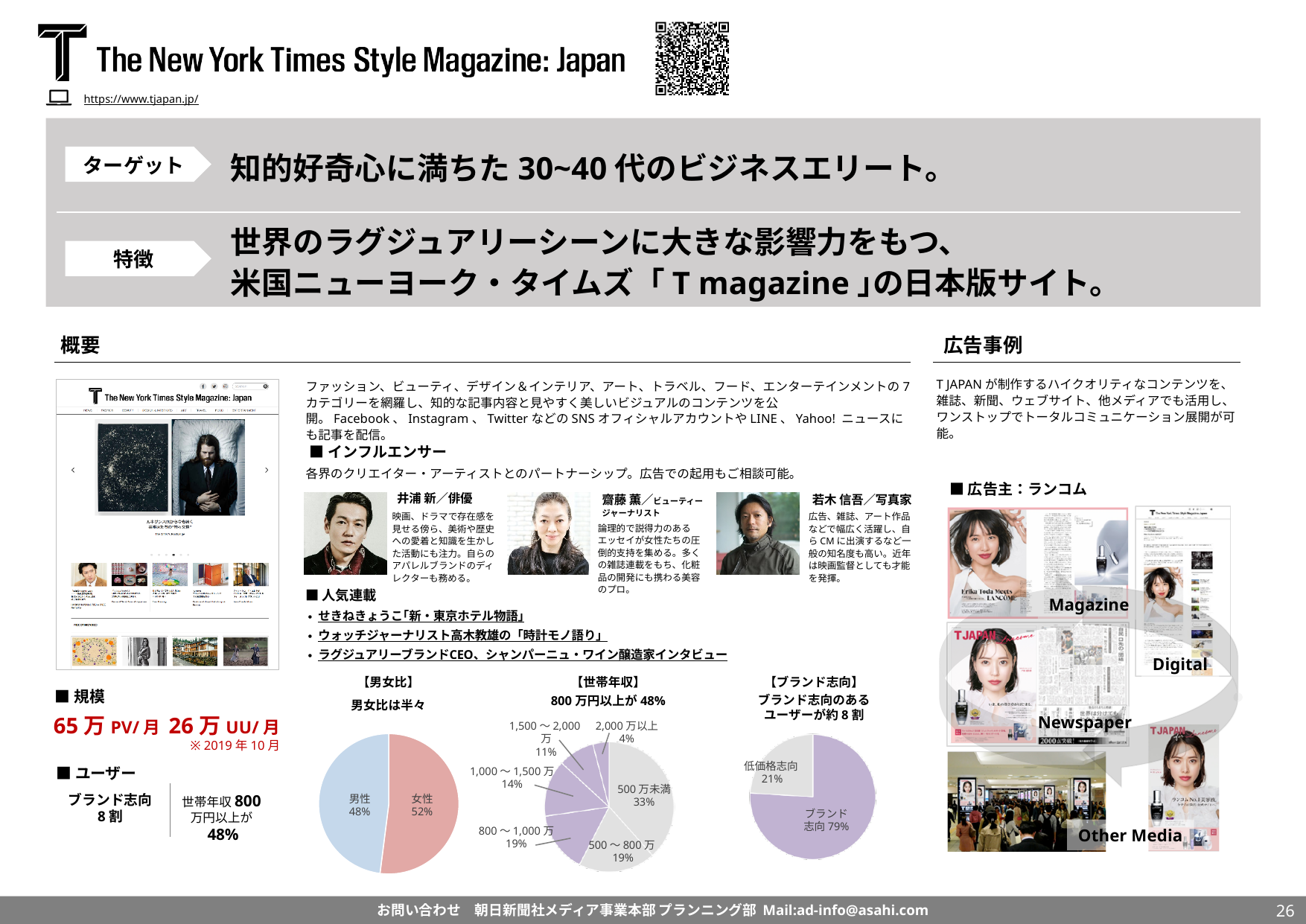
In the 【ブランド志向】 pie chart, what share is ブランド志向? 79% In the 【男女比】 pie chart, what share is 男性? 48% In the 【世帯年収】 pie chart, which category has the largest share? 500万未満 In the 【男女比】 pie chart, what share is 女性? 52% How many slices does the 【世帯年収】 pie chart have? 6 In the 【世帯年収】 pie chart, which category has the smallest share? 2,000万以上 In the 【ブランド志向】 pie chart, what is the difference between ブランド志向 and 低価格志向? 58% In the 【世帯年収】 pie chart, what share is 1,500〜2,000万? 11% What kind of chart is the 【世帯年収】 chart? Pie chart In the 【世帯年収】 pie chart, what is the difference between the shares of 500万未満 and 1,000〜1,500万? 19% In the 【世帯年収】 pie chart, what share is 500万未満? 33% In the 【男女比】 pie chart, which slice is larger, 男性 or 女性? 女性